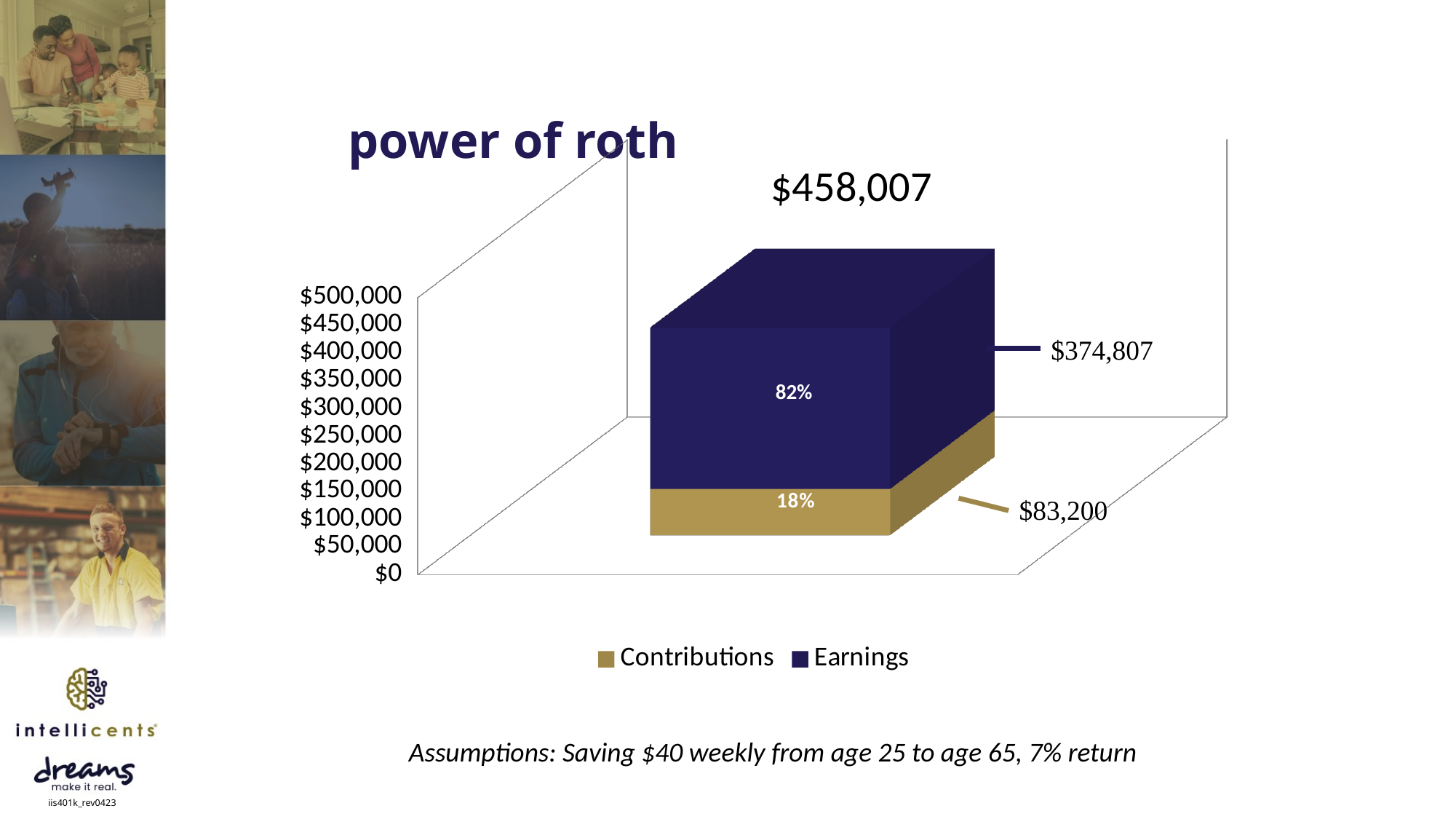
What is the title of the chart? power of roth What is the value of Earnings in the stacked bar? $374,807 Which series is larger, Contributions or Earnings? Earnings What kind of chart is shown on the slide? Stacked bar chart What percentage of the bar do Contributions represent? 18% What is the value of Contributions in the stacked bar? $83,200 What percentage of the bar do Earnings represent? 82% What is the total of the stacked bar? $458,007 How many series does the legend list? 2 What is the difference between Earnings and Contributions? $291,607 Is the value for Contributions greater or less than $100,000? less Which colour represents Earnings in the legend? Dark navy blue